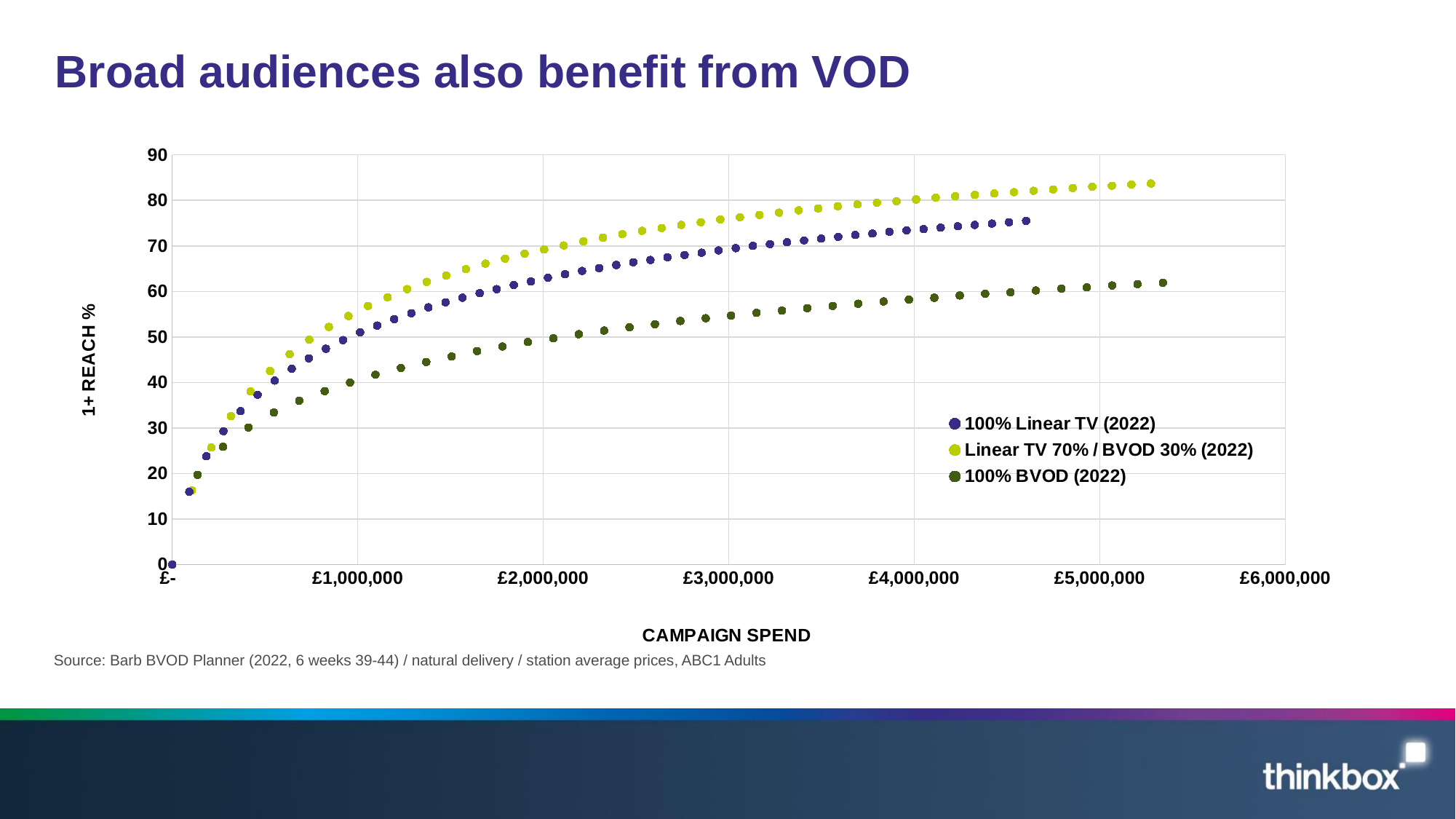
What kind of chart is shown on the slide? Scatter chart What is the label of the horizontal axis? CAMPAIGN SPEND At a campaign spend of £2,000,000, is the 1+ reach % for 100% Linear TV (2022) greater or less than 60? greater What is the label of the vertical axis? 1+ REACH % At a campaign spend of £5,000,000, is the 1+ reach % for Linear TV 70% / BVOD 30% (2022) greater or less than 80? greater Do the 1+ reach % values rise or fall as campaign spend increases? Rise How many series does the legend list? 3 At a campaign spend of £3,000,000, which series has the higher 1+ reach %: 100% Linear TV (2022) or 100% BVOD (2022)? 100% Linear TV (2022) At a campaign spend of £3,000,000, is the 1+ reach % for Linear TV 70% / BVOD 30% (2022) greater or less than 70? greater Which series reaches the highest 1+ reach % on the chart? Linear TV 70% / BVOD 30% (2022)